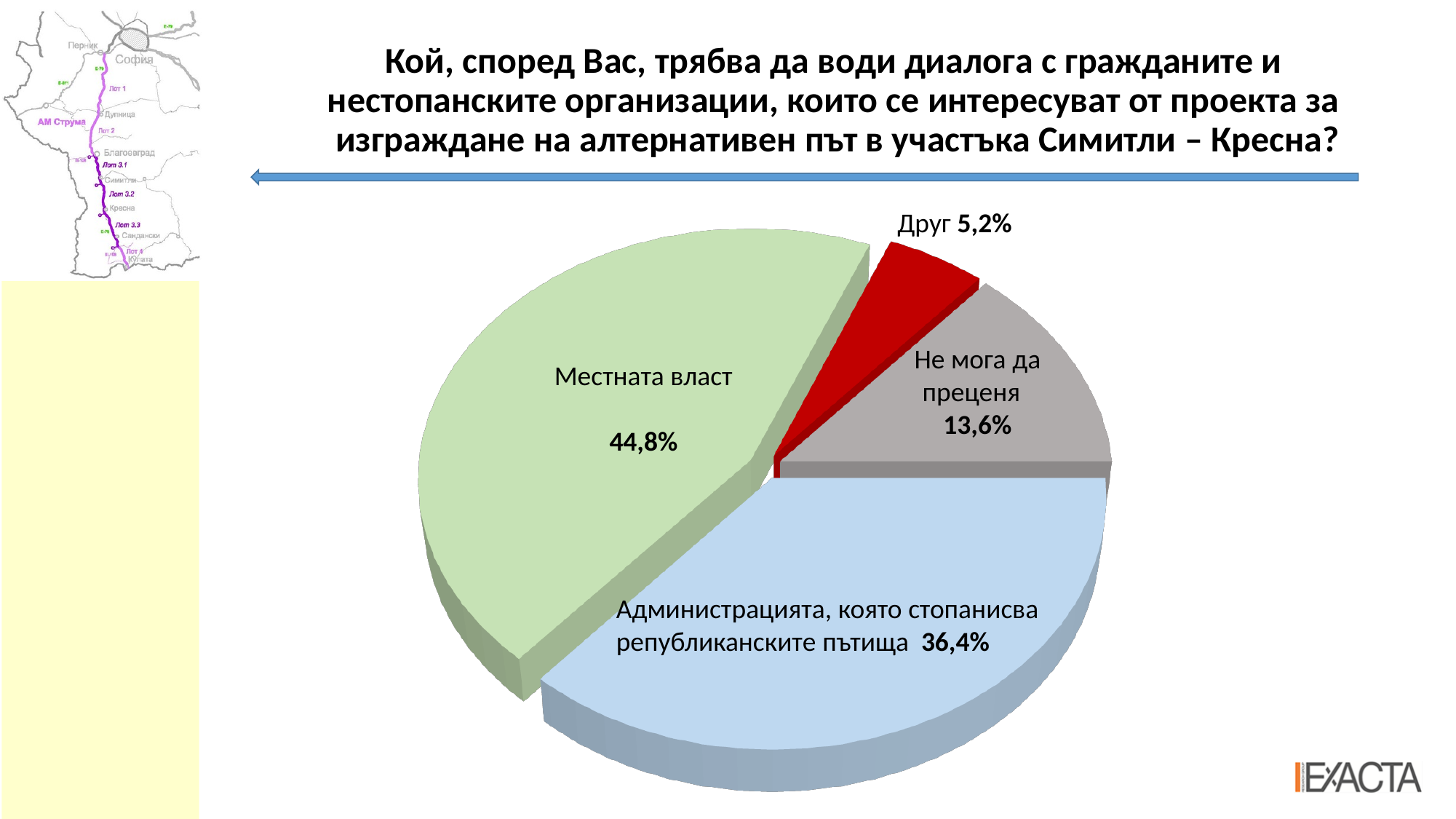
What is the difference between the shares for "Местната власт" and "Администрацията, която стопанисва републиканските пътища"? 8,4% What share of respondents answered "Не мога да преценя"? 13,6% Which answer has the largest share of the pie? Местната власт How many slices does the pie chart have? 4 What type of chart is shown on the slide? Pie chart Which is larger: the share for "Не мога да преценя" or the share for "Друг"? Не мога да преценя What colour is the slice for "Друг"? Red What is the difference between the shares for "Не мога да преценя" and "Друг"? 8,4% Which answer has the smallest share of the pie? Друг What share of respondents answered "Друг"? 5,2% What share of respondents chose "Администрацията, която стопанисва републиканските пътища"? 36,4% What share of respondents chose "Местната власт"? 44,8%